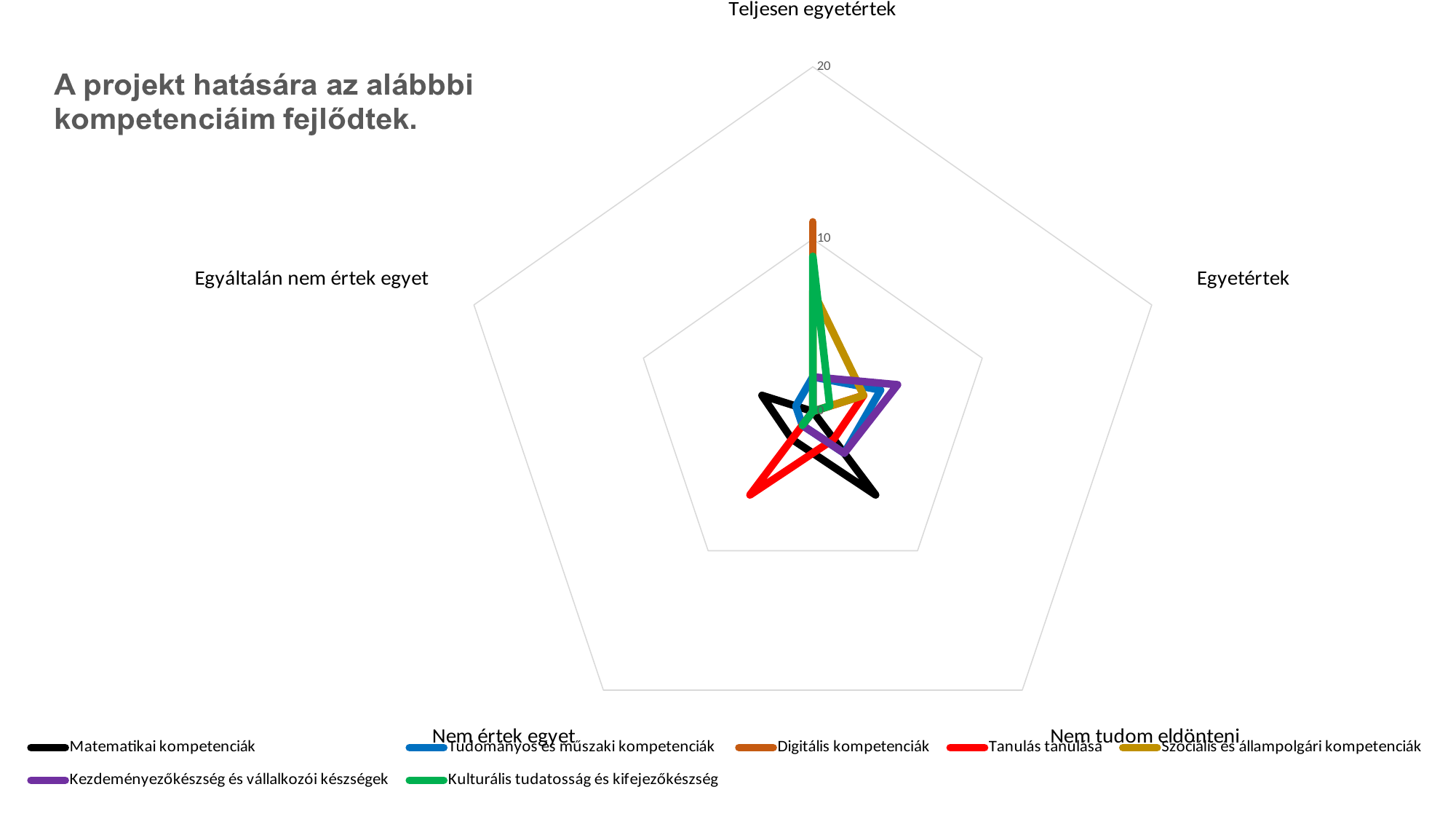
Is the value for Digitális kompetenciák on the Teljesen egyetértek axis greater or less than 10? greater What kind of chart is shown on the slide? Radar chart How many category axes does the radar chart have? 5 Is the value for Digitális kompetenciák on the Teljesen egyetértek axis greater or less than 20? less Is the value for Kezdeményezőkészség és vállalkozói készségek on the Egyetértek axis greater or less than 10? less How many series does the legend list? 7 What is the title of the chart? A projekt hatására az alábbbi kompetenciáim fejlődtek. Which colour represents Matematikai kompetenciák in the legend? Black Which series reaches the highest value on the Teljesen egyetértek axis? Digitális kompetenciák Which is larger: the value for Digitális kompetenciák on the Teljesen egyetértek axis or the value for Matematikai kompetenciák on the Nem tudom eldönteni axis? Digitális kompetenciák on Teljesen egyetértek